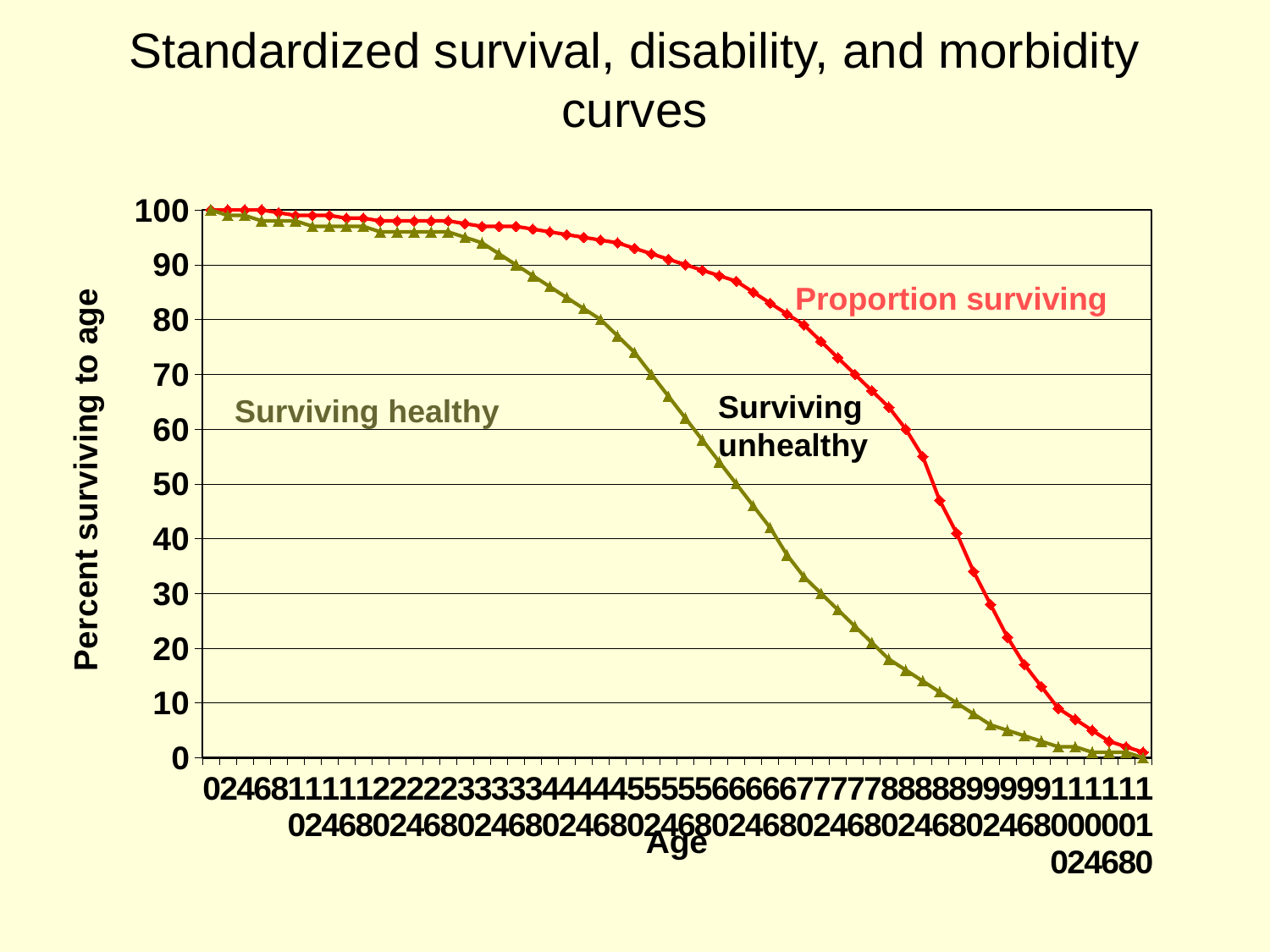
What is the title of the chart? Standardized survival, disability, and morbidity curves What is the value of the Proportion surviving curve at the start of the x axis (age 0)? 100 What kind of chart is shown on the slide? line chart What is the lowest value shown on the vertical axis? 0 What label is given to the gap between the Proportion surviving and Surviving healthy curves? Surviving unhealthy What is the highest value shown on the vertical axis? 100 How many curves (series) are plotted on the chart? 2 Which curve drops below 50 percent at a younger age, Proportion surviving or Surviving healthy? Surviving healthy What is the label of the vertical axis? Percent surviving to age Is the value of the Surviving healthy curve at the far right end of the x axis greater or less than 10? less Which curve lies above the other across the chart, Proportion surviving or Surviving healthy? Proportion surviving Do the curves rise or fall as age increases along the x axis? fall